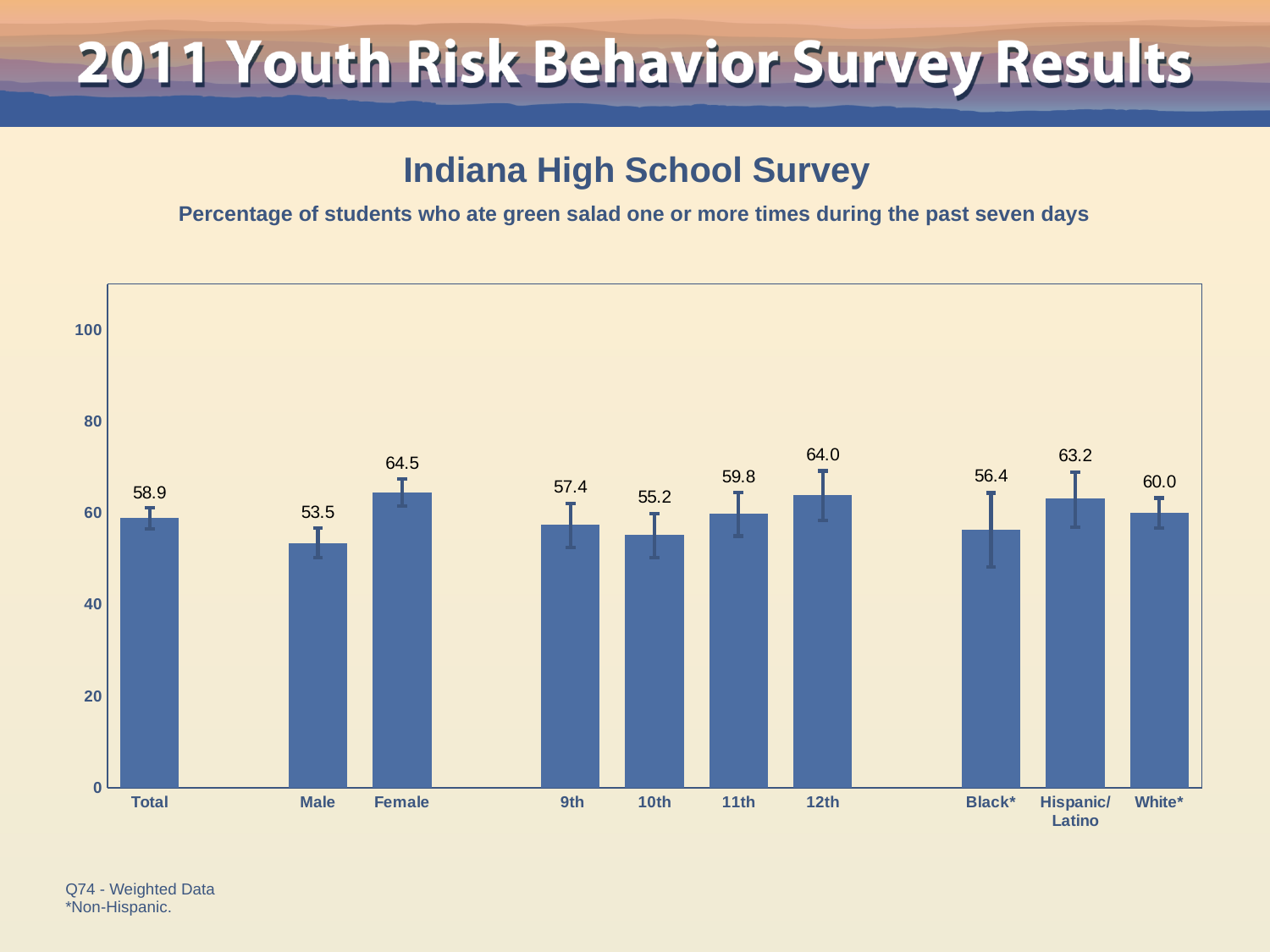
Which is larger, the value for 12th or the value for 9th? 12th What is the difference between the Female and Male values? 11.0 Is the value for Black* greater or less than 40? greater Which category has the highest value? Female What is the value for 10th grade? 55.2 How many categories are shown on the x axis? 10 What kind of chart is this? bar chart What is the subtitle describing what the chart measures? Percentage of students who ate green salad one or more times during the past seven days Do the values rise or fall from 10th to 12th grade? rise What is the value for Female? 64.5 Which category has the lowest value? Male What is the value for Hispanic/Latino? 63.2